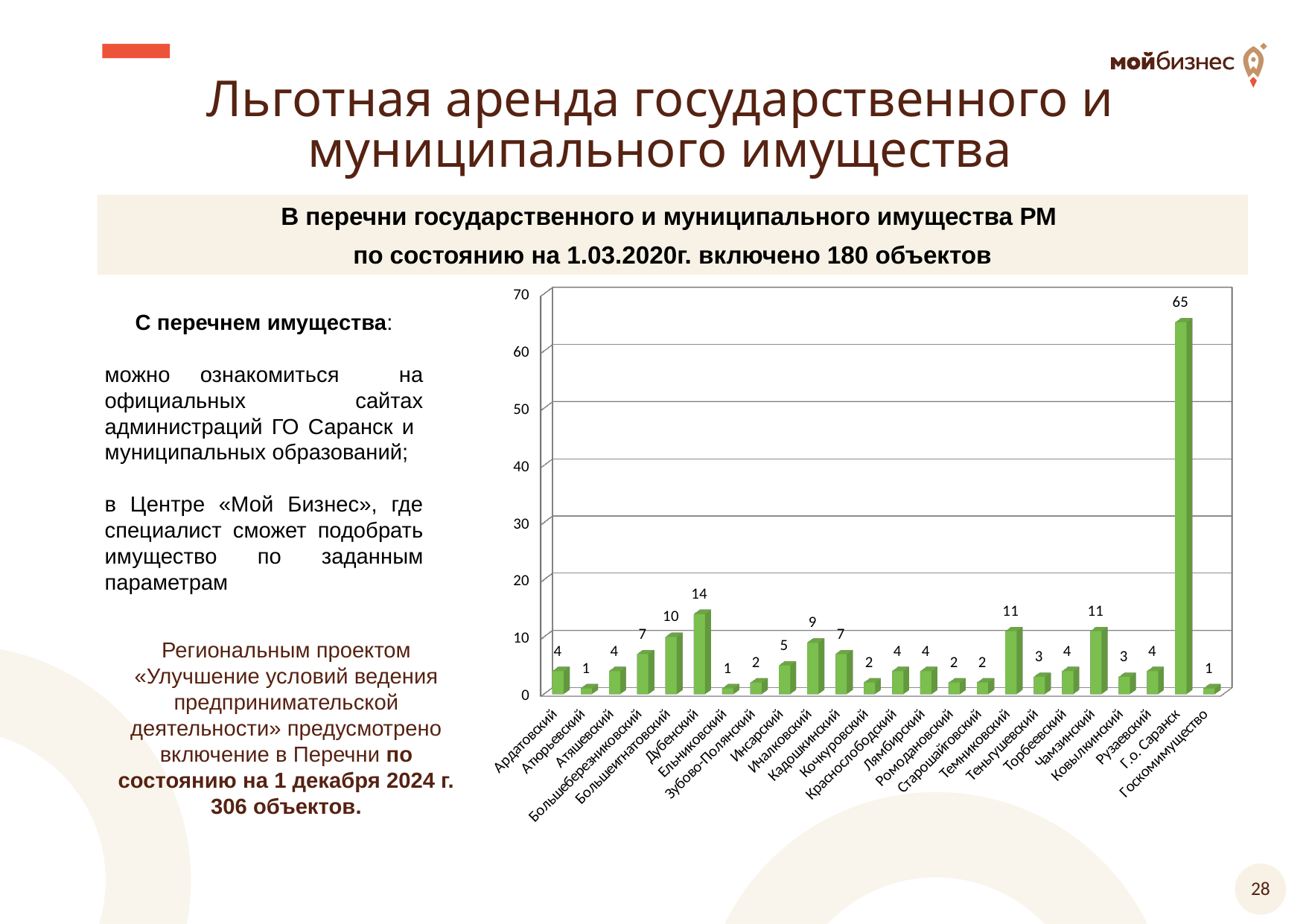
How many categories are shown on the x axis? 24 Which category has the highest value? Г.о. Саранск What is the value for Темниковский? 11 What is the value for Г.о. Саранск? 65 What is the difference between the values for Большеигнатовский and Инсарский? 5 What is the value for Большеигнатовский? 10 Is the value for Г.о. Саранск greater or less than 60? greater Which is larger, the value for Кадошкинский or the value for Теньгушевский? Кадошкинский What is the value for Дубенский? 14 What is the difference between the values for Г.о. Саранск and Дубенский? 51 What is the value for Ичалковский? 9 What kind of chart is shown on the slide? bar chart